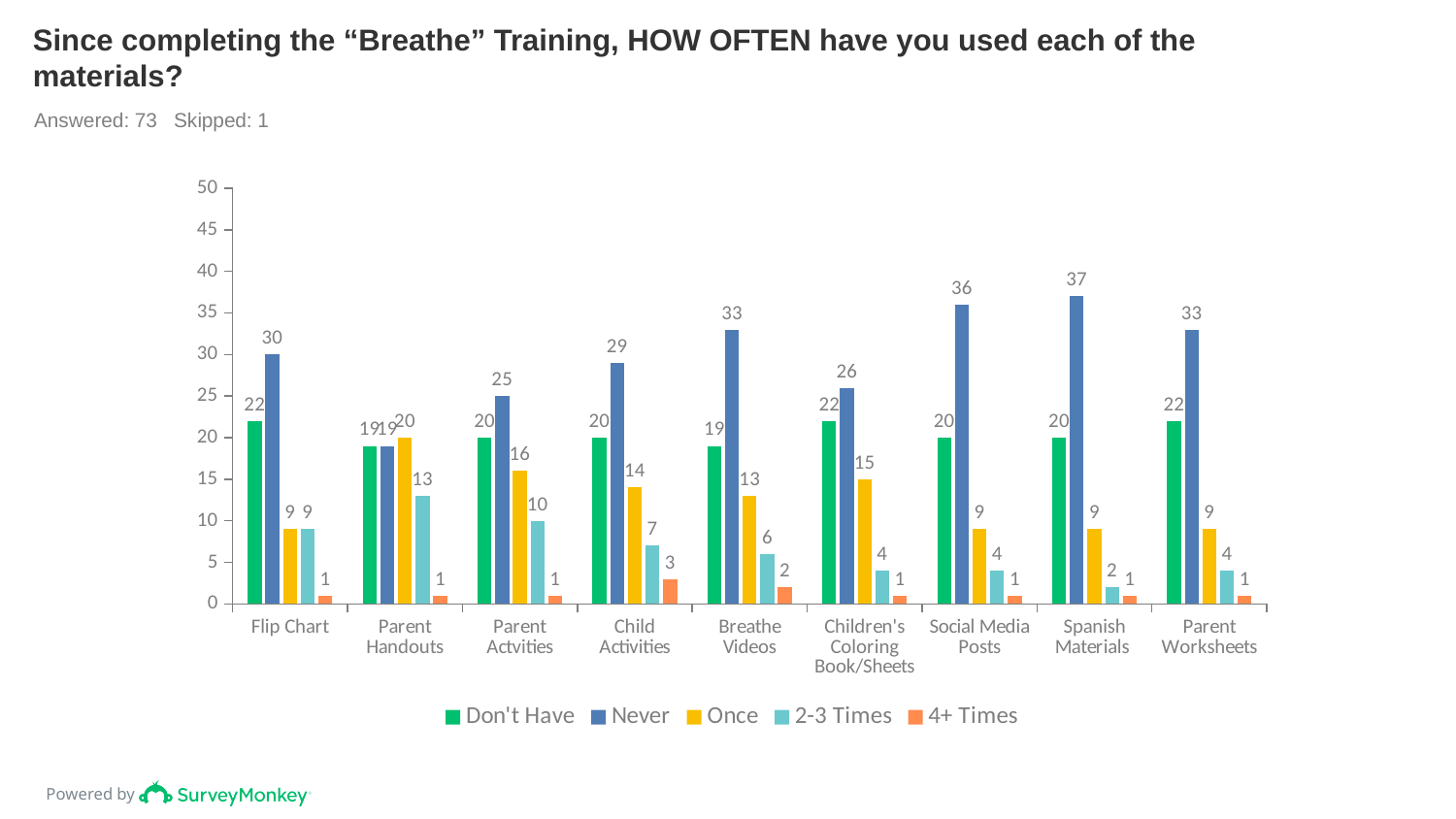
How many series does the legend list? 5 What kind of chart is shown on the slide? Bar chart Which series is shown in orange in the legend? 4+ Times What is the "4+ Times" value for Child Activities? 3 Which is larger, the "Once" value for Parent Actvities or the "Once" value for Breathe Videos? Parent Actvities How many categories are shown on the x axis? 9 What is the difference between the "Never" values for Social Media Posts and Flip Chart? 6 What is the "Once" value for Parent Handouts? 20 Which category has the highest "Never" value? Spanish Materials What is the "2-3 Times" value for Parent Actvities? 10 Which category has the lowest "2-3 Times" value? Spanish Materials What is the "Never" value for Spanish Materials? 37